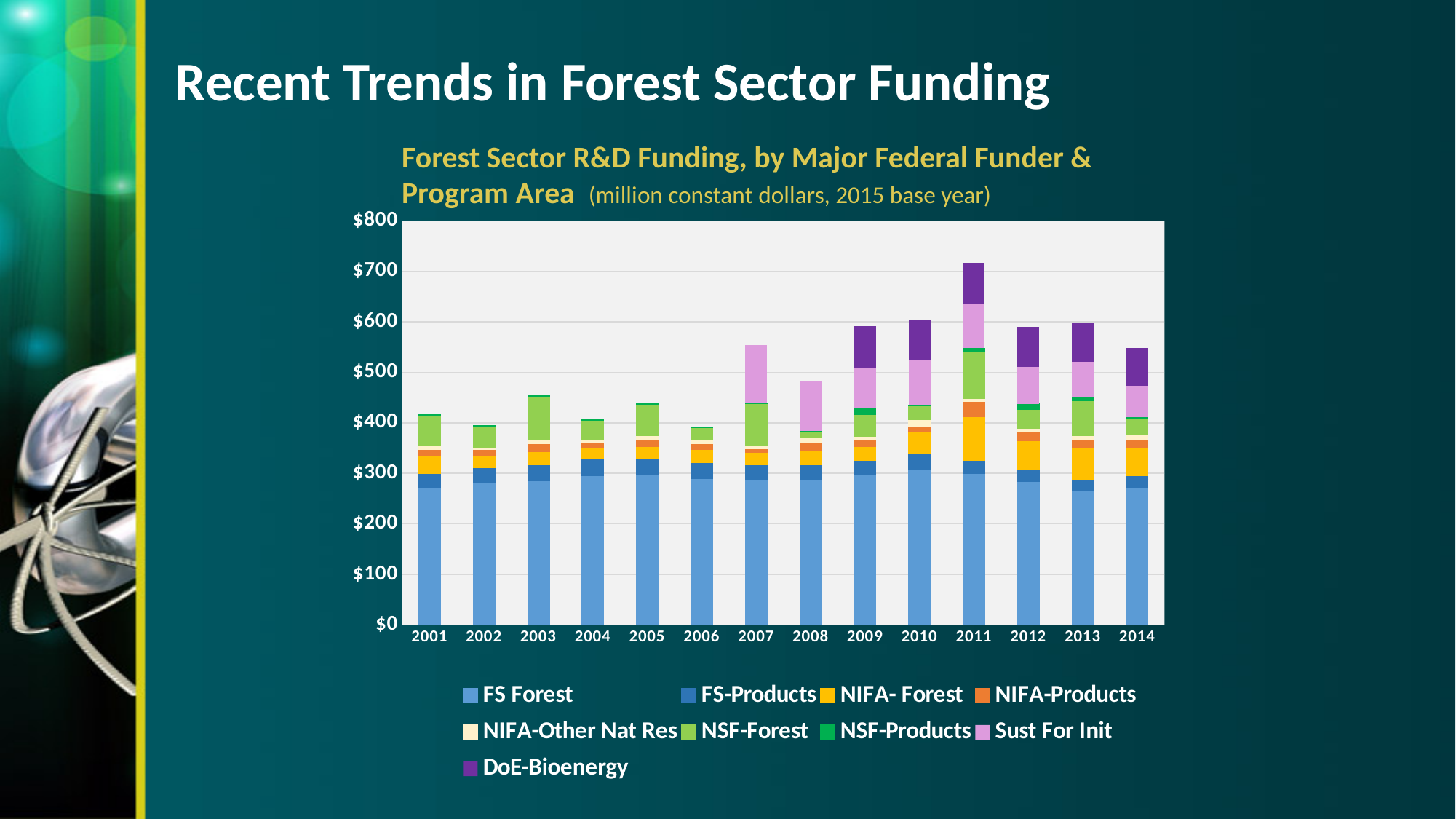
Is the total funding for 2011 greater or less than $600? greater Is the total funding for 2006 greater or less than $400? less What kind of chart is shown on the slide? Stacked bar chart Which series forms the bottom segment of each stacked bar? FS Forest Is the total funding for 2014 greater or less than $500? greater Which year has the larger total funding, 2010 or 2011? 2011 How many years are shown along the x axis of the chart? 14 Which year has the larger total funding, 2007 or 2008? 2007 In what units are the values on the chart expressed, according to the chart subtitle? million constant dollars, 2015 base year How many series does the chart's legend list? 9 Which year has the highest total forest sector R&D funding? 2011